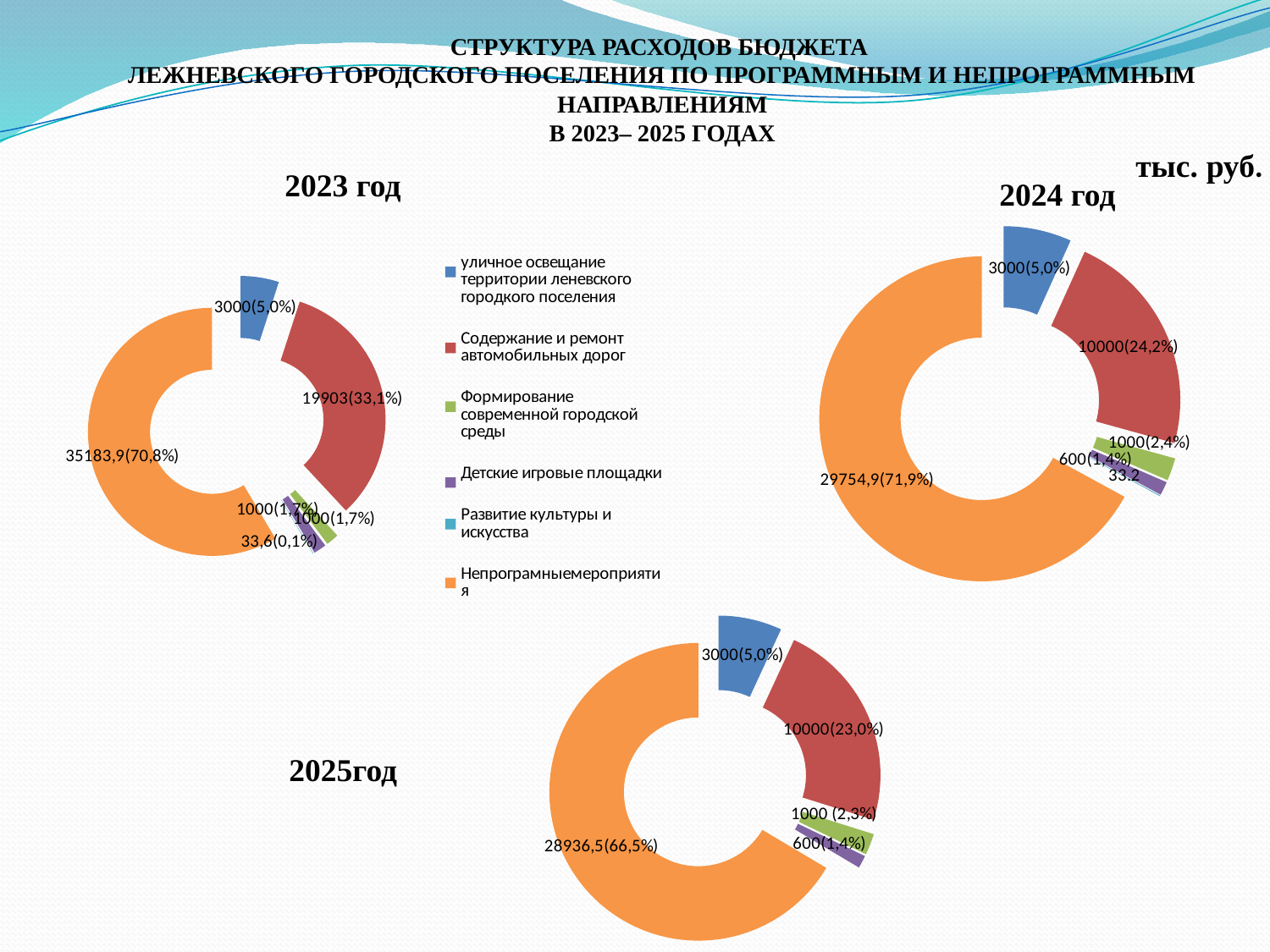
What unit is stated for the values on the slide? тыс. руб. How many entries does the legend list? 6 What kind of chart is used for the 2023 год chart? doughnut (pie) chart In the 2025 год chart, what share of the total is Содержание и ремонт автомобильных дорог (red)? 23,0% In the 2024 год chart, what share of the total is Непрограмные мероприятия (orange)? 71,9% In the 2025 год chart, which category has the largest slice? Непрограмные мероприятия In the 2023 год chart, what is the value for Содержание и ремонт автомобильных дорог (red)? 19903(33,1%) In the 2024 год chart, what is the value for Содержание и ремонт автомобильных дорог (red)? 10000(24,2%) In the 2025 год chart, what is the value for Непрограмные мероприятия (orange)? 28936,5(66,5%) What is the difference between the Непрограмные мероприятия value in the 2024 год chart and in the 2025 год chart? 818,4 In the 2024 год chart, which is larger: уличное освещение (blue) or Содержание и ремонт автомобильных дорог (red)? Содержание и ремонт автомобильных дорог In the 2023 год chart, what is the value for Непрограмные мероприятия (orange)? 35183,9(70,8%)